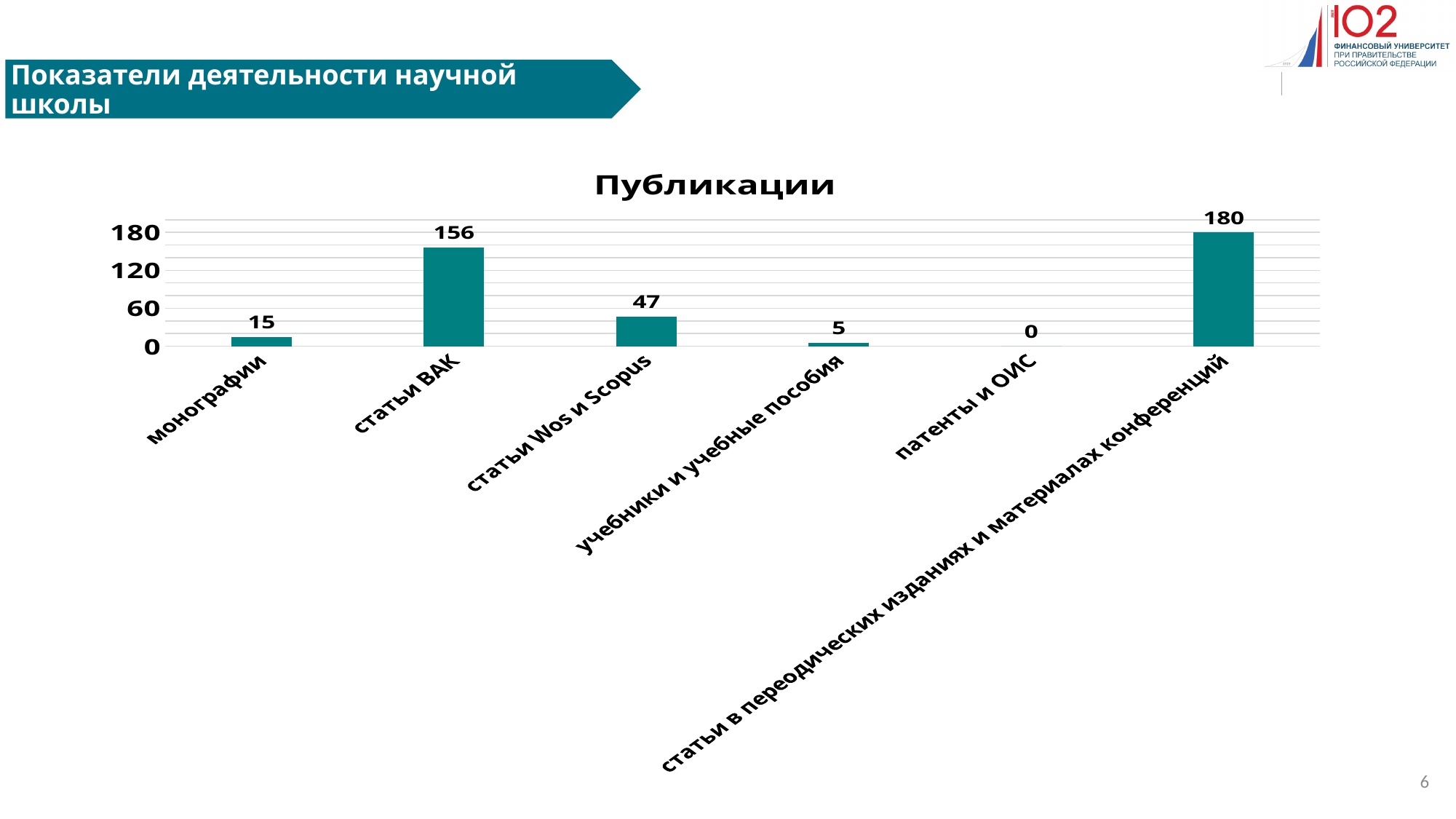
How many categories are shown in the Публикации chart? 6 What is the value for статьи Wos и Scopus in the Публикации chart? 47 What is the value for статьи ВАК in the Публикации chart? 156 What is the difference between the values for статьи ВАК and статьи Wos и Scopus in the Публикации chart? 109 Is the value for статьи ВАК greater or less than 120 in the Публикации chart? greater Which is larger in the Публикации chart: монографии or учебники и учебные пособия? монографии What kind of chart is the Публикации chart? bar chart Which category has the lowest value in the Публикации chart? патенты и ОИС Which category has the highest value in the Публикации chart? статьи в переодических изданиях и материалах конференций What is the title of the chart on the slide? Публикации What is the value for патенты и ОИС in the Публикации chart? 0 What is the value for монографии in the Публикации chart? 15